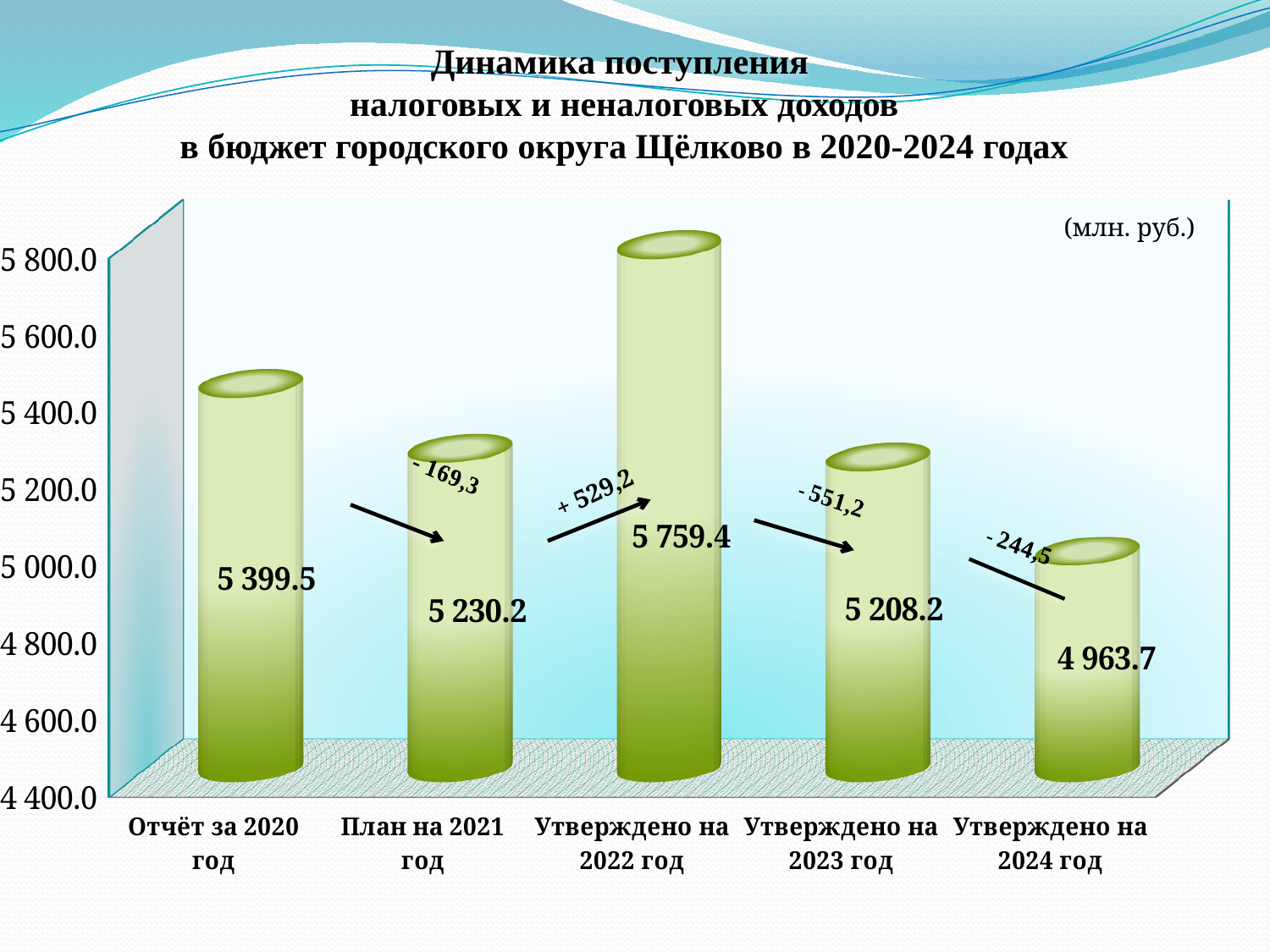
What is the value for «Утверждено на 2022 год»? 5 759.4 What kind of chart is shown on the slide? bar chart Is the value for «Утверждено на 2024 год» greater or less than 5 000.0? less Which category has the lowest value? Утверждено на 2024 год Which category has the highest value? Утверждено на 2022 год Which is larger: the value for «Отчёт за 2020 год» or for «Утверждено на 2023 год»? Отчёт за 2020 год In what units are the values on the chart given? млн. руб. What is the difference between the values for «Утверждено на 2022 год» and «Утверждено на 2023 год»? 551.2 What is the value for «Утверждено на 2024 год»? 4 963.7 How many categories are shown on the chart? 5 What is the difference between the values for «Отчёт за 2020 год» and «План на 2021 год»? 169.3 What is the value for «Отчёт за 2020 год»? 5 399.5